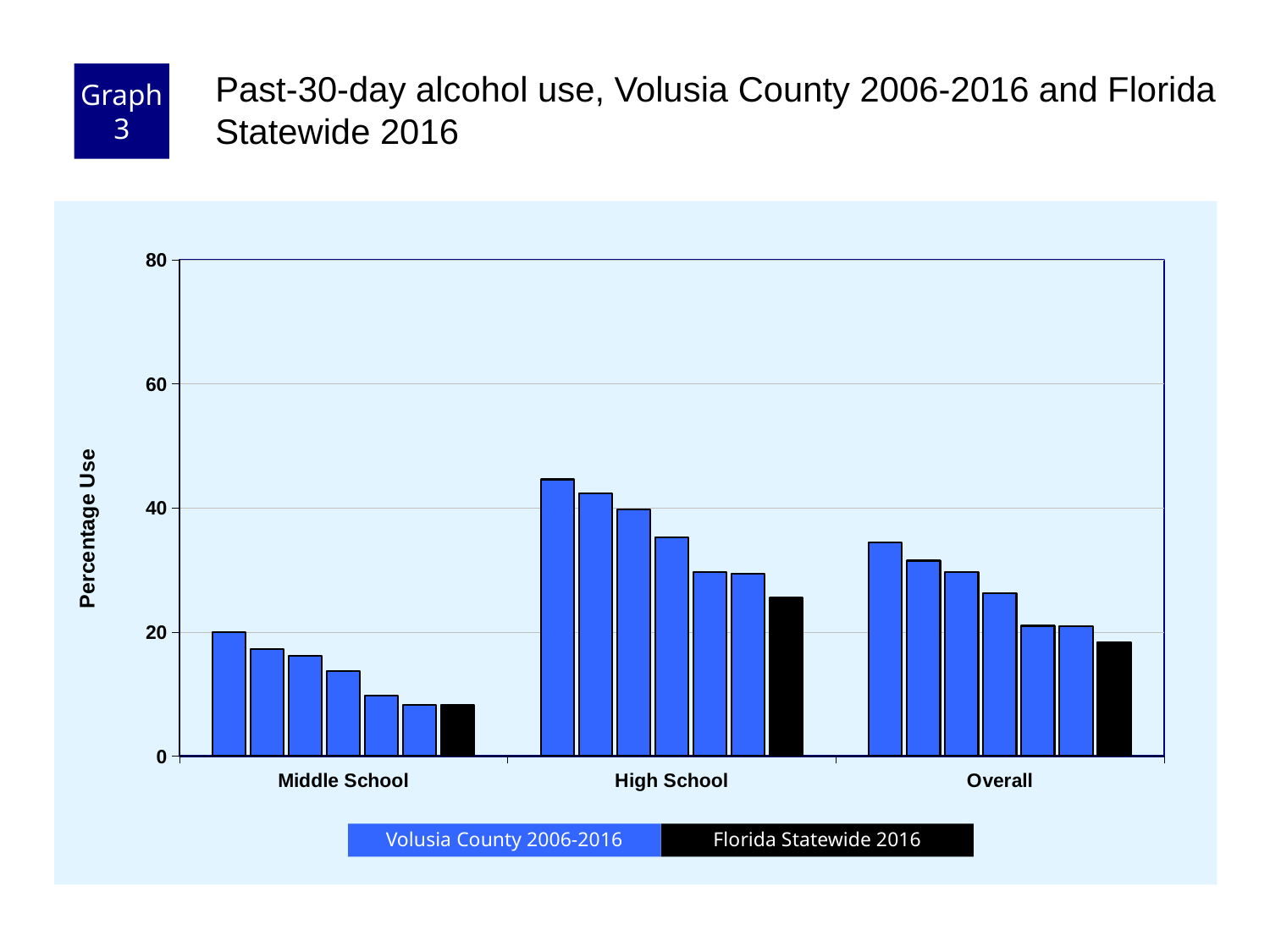
Is the Florida Statewide 2016 value for High School greater or less than 20? greater Which is larger, the Florida Statewide 2016 bar for High School or the Florida Statewide 2016 bar for Middle School? High School What kind of chart is shown on the slide? bar chart Which category has the highest bars overall? High School Within the High School group, do the Volusia County bars rise or fall from left to right? fall Which category has the lowest bars overall? Middle School How many school-level categories are shown on the x axis? 3 Within the Middle School group, do the Volusia County bars rise or fall from left to right? fall What is the label on the y axis? Percentage Use Is the value of the tallest High School bar greater or less than 40? greater How many series does the legend list? 2 Is the Florida Statewide 2016 value for Middle School greater or less than 20? less